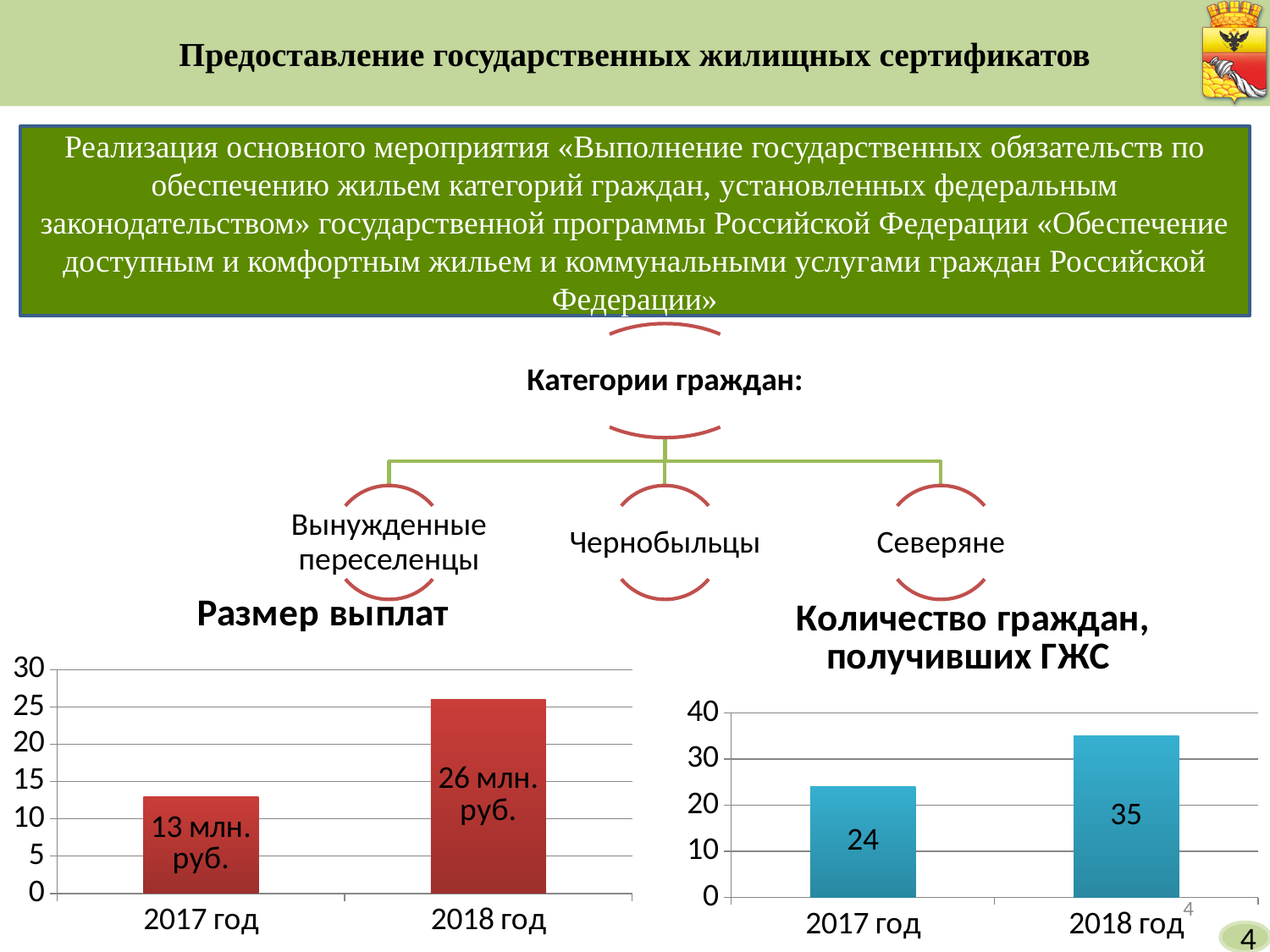
In the 'Количество граждан, получивших ГЖС' chart, which year has the lower value? 2017 год In the 'Количество граждан, получивших ГЖС' chart, what is the value for 2017 год? 24 In the 'Количество граждан, получивших ГЖС' chart, is the value for 2018 год greater or less than 30? greater In the 'Размер выплат' chart, what is the difference between the 2018 год and 2017 год values? 13 млн. руб. How many categories does the 'Размер выплат' chart show? 2 In the 'Размер выплат' chart, do the values rise or fall from 2017 год to 2018 год? rise In the 'Количество граждан, получивших ГЖС' chart, what is the difference between the 2018 год and 2017 год values? 11 In the 'Размер выплат' chart, what is the value for 2017 год? 13 млн. руб. In the 'Количество граждан, получивших ГЖС' chart, what is the value for 2018 год? 35 In the 'Размер выплат' chart, what is the value for 2018 год? 26 млн. руб. What kind of chart is the 'Количество граждан, получивших ГЖС' chart? bar chart In the 'Размер выплат' chart, which year has the higher value? 2018 год